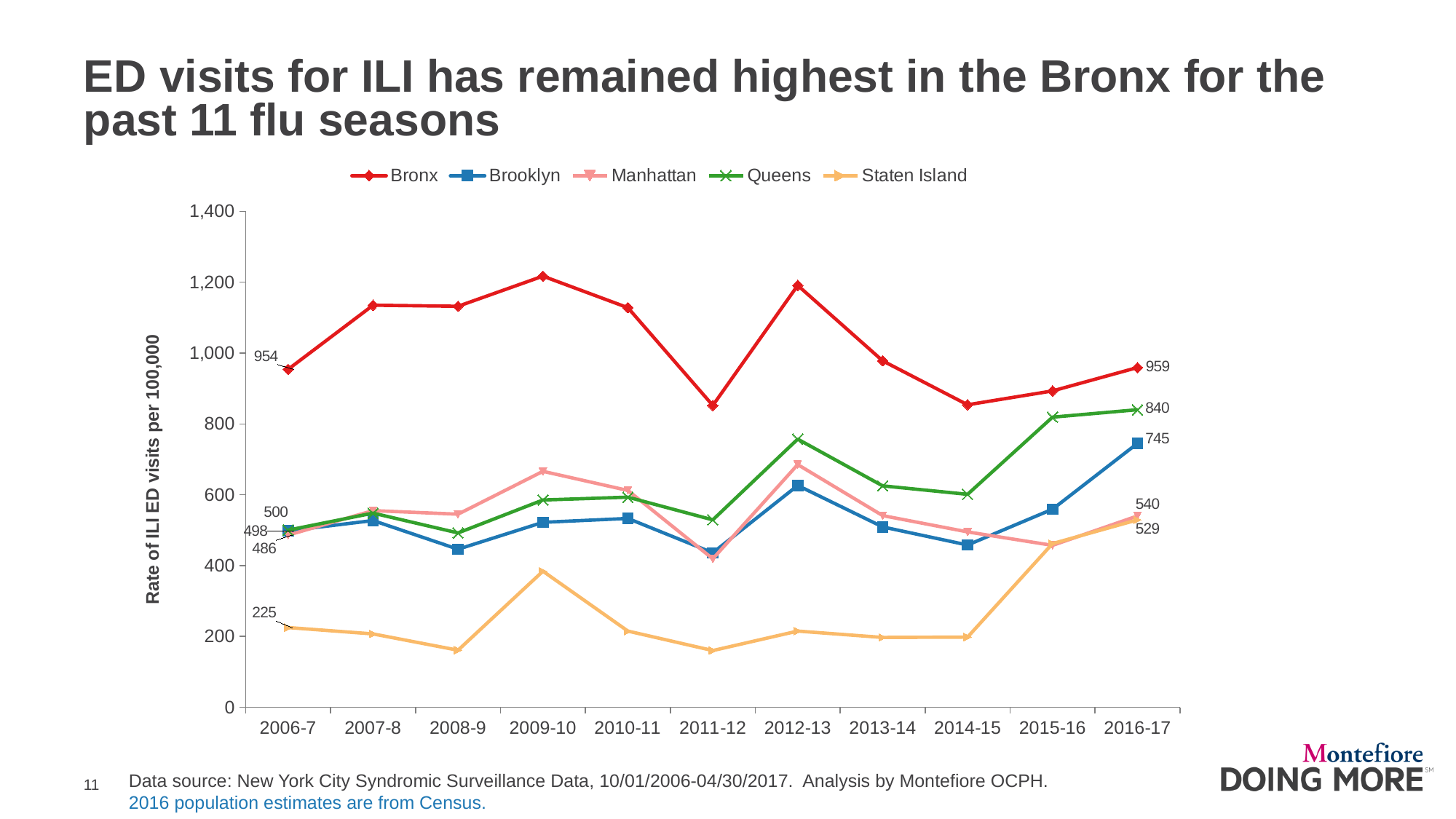
What is the rate of ILI ED visits per 100,000 for the Bronx in 2006-7? 954 What is the value for Queens in 2016-17? 840 What is the value for Manhattan in 2016-17? 540 Which borough has the lowest rate of ILI ED visits in 2016-17? Staten Island What is the rate of ILI ED visits per 100,000 for the Bronx in 2016-17? 959 How many flu seasons are shown on the x axis? 11 What is the value for Staten Island in 2006-7? 225 What is the difference between the Bronx and Queens values in 2016-17? 119 Is the value for the Bronx in 2011-12 greater or less than 1,000? less How many series does the legend list? 5 What is the value for Brooklyn in 2016-17? 745 Which borough has the highest rate of ILI ED visits in 2016-17? Bronx